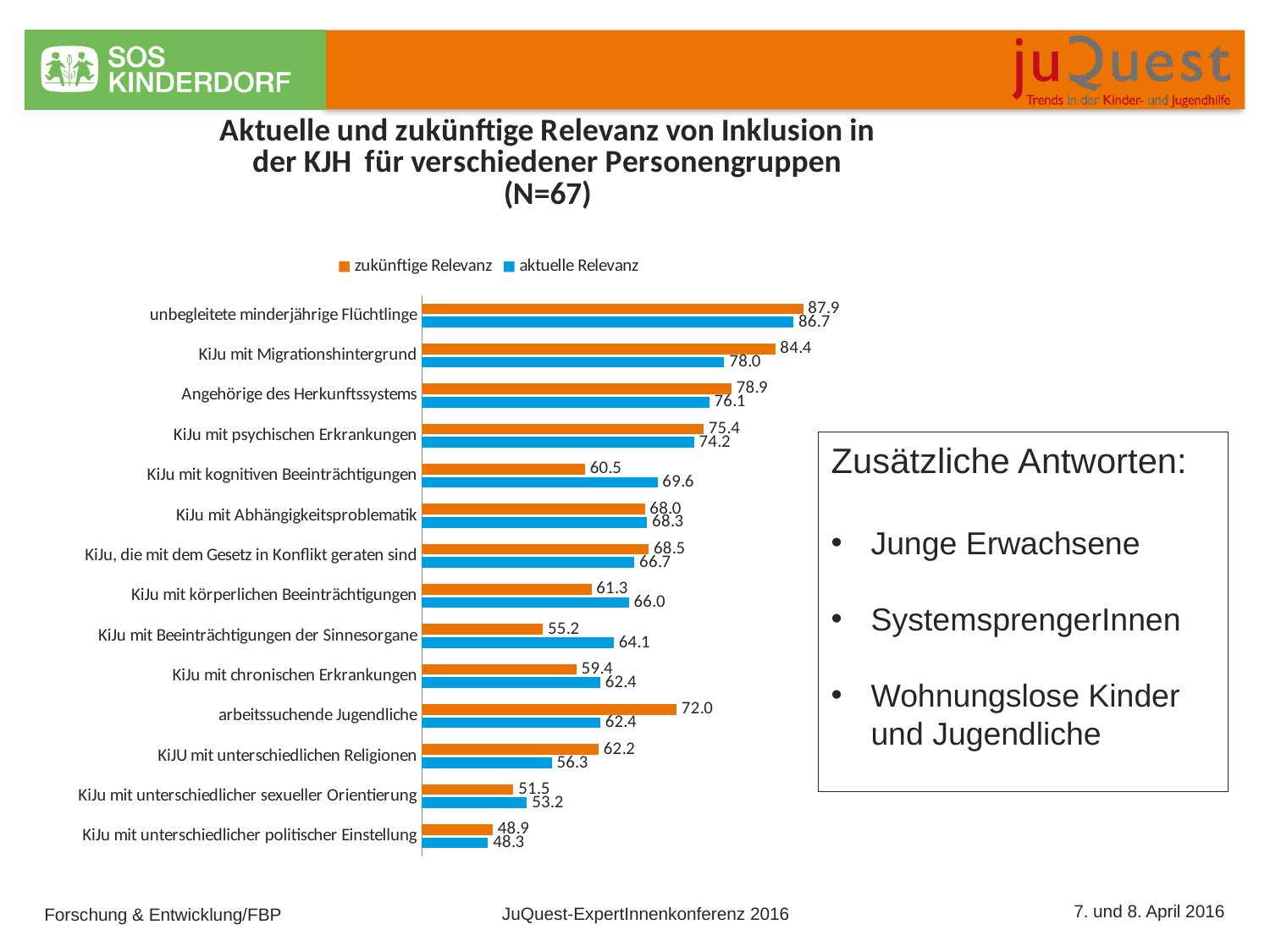
What kind of chart is shown on the slide? bar chart What is the value of 'zukünftige Relevanz' for 'arbeitssuchende Jugendliche'? 72.0 Which category has the highest value for 'zukünftige Relevanz'? unbegleitete minderjährige Flüchtlinge Which category has the lowest value for 'aktuelle Relevanz'? KiJu mit unterschiedlicher politischer Einstellung What is the difference between 'aktuelle Relevanz' and 'zukünftige Relevanz' for 'KiJu mit Beeinträchtigungen der Sinnesorgane'? 8.9 What is the value of 'aktuelle Relevanz' for 'KiJu mit kognitiven Beeinträchtigungen'? 69.6 How many series does the chart legend list? 2 How many categories (person groups) are shown in the chart? 14 Which colour represents the series 'zukünftige Relevanz' in the chart? orange What is the difference between 'zukünftige Relevanz' and 'aktuelle Relevanz' for 'arbeitssuchende Jugendliche'? 9.6 For 'KiJu mit körperlichen Beeinträchtigungen', which is larger: 'zukünftige Relevanz' or 'aktuelle Relevanz'? aktuelle Relevanz What is the value of 'aktuelle Relevanz' for 'KiJu mit Migrationshintergrund'? 78.0